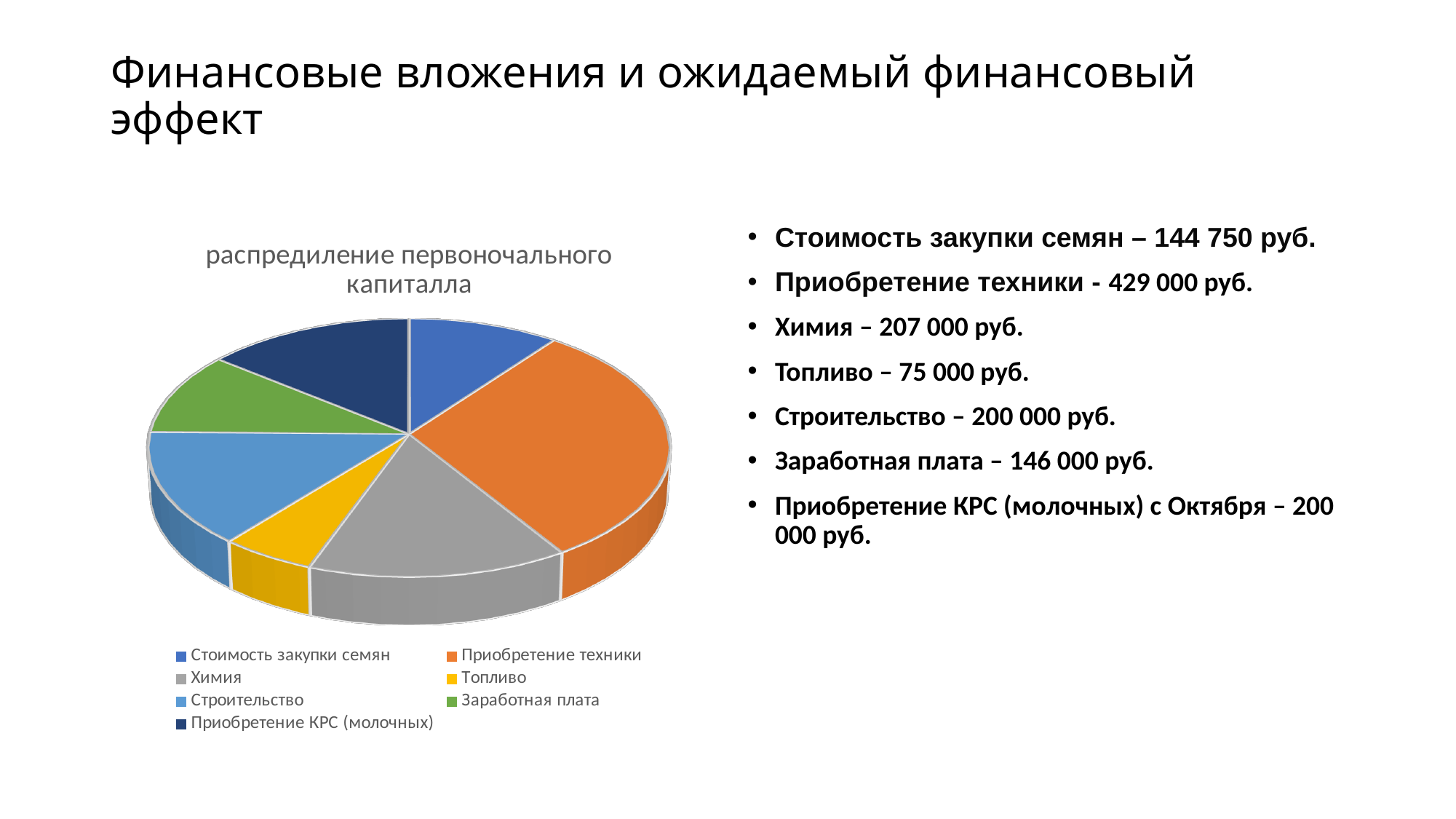
What colour is the slice for Химия in the pie chart? Gray How many slices does the pie chart have? 7 What is the value for Приобретение техники? 429 000 руб. Which category has the largest slice in the pie chart? Приобретение техники What is the value for Топливо? 75 000 руб. What kind of chart is shown on the slide? Pie chart What is the difference between Приобретение техники and Химия? 222 000 руб. How many entries does the legend of the pie chart list? 7 Which is larger, Строительство or Заработная плата? Строительство Which category has the smallest slice in the pie chart? Топливо What is the value for Стоимость закупки семян? 144 750 руб. What is the title of the pie chart? распредиление первоночального капиталла